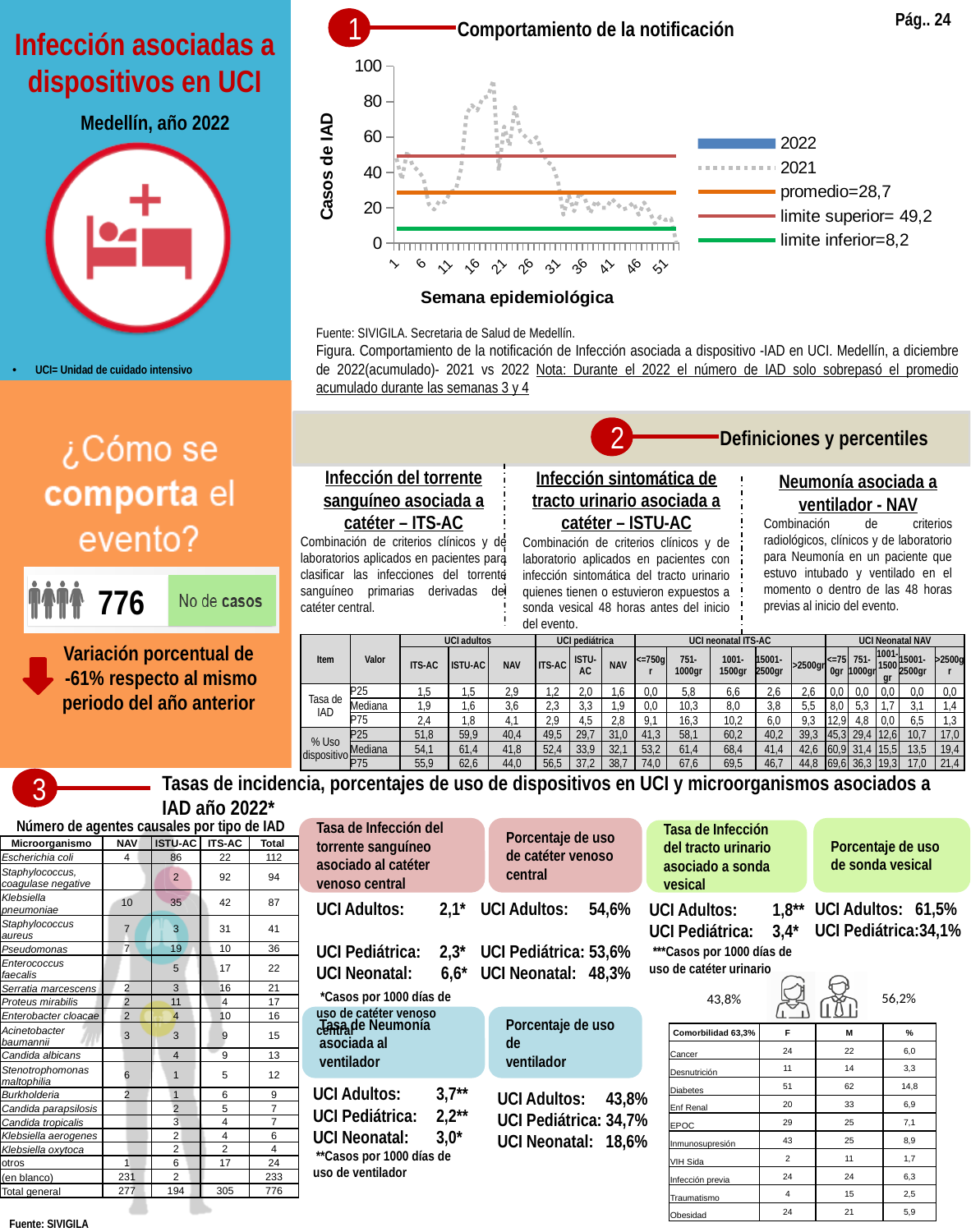
What kind of chart is shown under 'Comportamiento de la notificación'? line chart How many series does the legend of the 'Comportamiento de la notificación' chart list? 5 In the 'Comportamiento de la notificación' chart, what is the difference between the 'limite superior' and the 'limite inferior'? 41,0 What is the x-axis title of the 'Comportamiento de la notificación' chart? Semana epidemiológica In the 'Comportamiento de la notificación' chart, which is larger, the 'promedio' or the 'limite inferior'? promedio In the 'Comportamiento de la notificación' chart, what value is given for 'promedio' in the legend? 28,7 In the 'Comportamiento de la notificación' chart, what value is given for 'limite inferior'? 8,2 In the 'Comportamiento de la notificación' chart, is the 2021 value at week 1 greater or less than 20? greater In the 'Comportamiento de la notificación' chart, what value is given for 'limite superior'? 49,2 In the 'Comportamiento de la notificación' chart, what is the difference between the 'limite superior' and the 'promedio'? 20,5 What is the y-axis title of the 'Comportamiento de la notificación' chart? Casos de IAD In the 'Comportamiento de la notificación' chart, is the highest value of the 2021 series greater or less than 80? greater